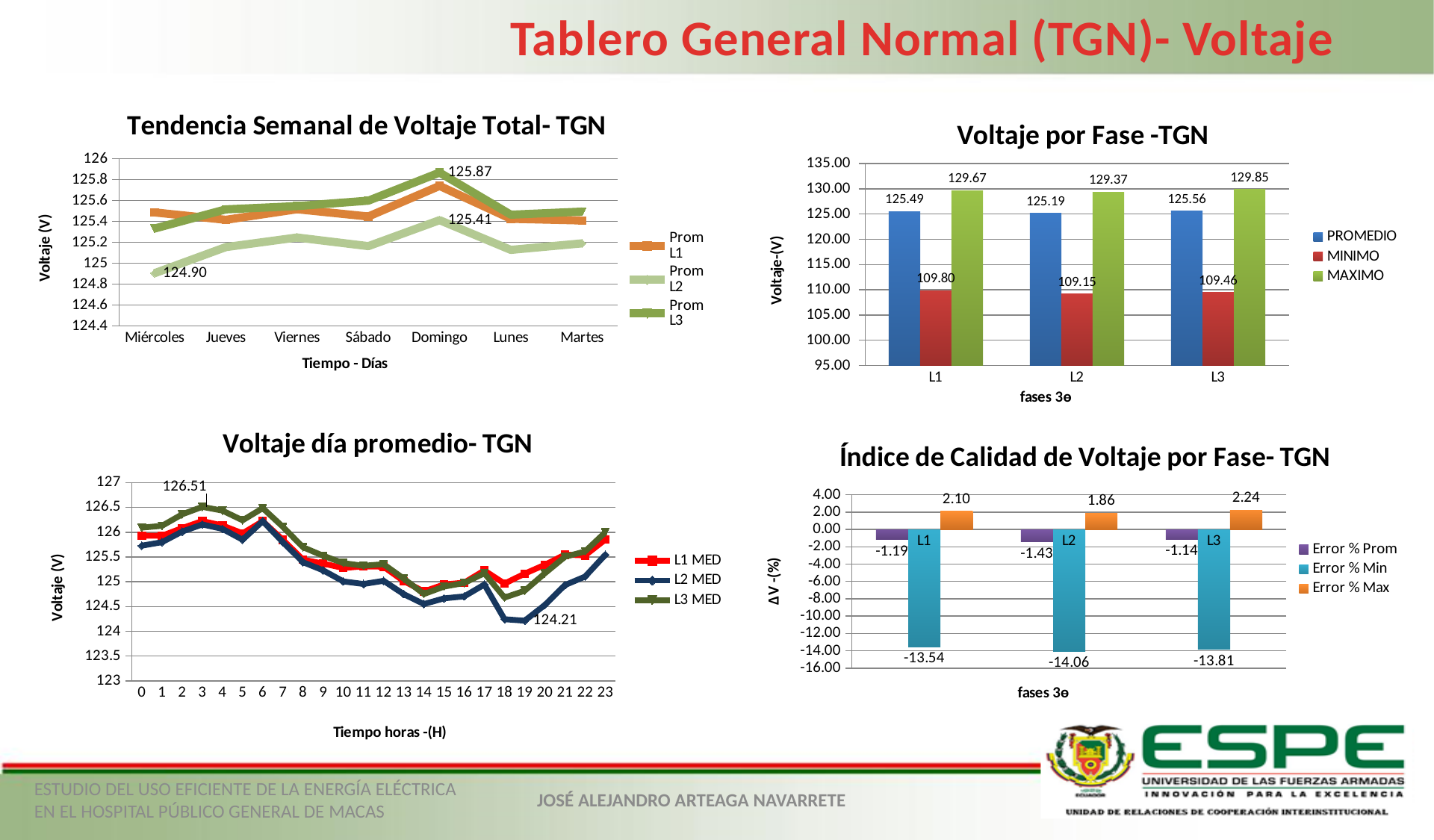
In the 'Índice de Calidad de Voltaje por Fase- TGN' chart, what is the Error % Min value for L2? -14.06 In the 'Voltaje día promedio- TGN' chart, what is the lowest labelled value shown? 124.21 In the 'Voltaje por Fase -TGN' chart, is the PROMEDIO value for L2 greater or less than 120.00? greater In the 'Tendencia Semanal de Voltaje Total- TGN' chart, how many days are shown on the x axis? 7 In the 'Voltaje por Fase -TGN' chart, what is the MAXIMO value for L3? 129.85 What kind of chart is 'Voltaje día promedio- TGN'? Line chart In the 'Tendencia Semanal de Voltaje Total- TGN' chart, what is the labelled value of Prom L3 on Domingo? 125.87 In the 'Voltaje por Fase -TGN' chart, what is the MINIMO value for L2? 109.15 In the 'Índice de Calidad de Voltaje por Fase- TGN' chart, how many series does the legend list? 3 In the 'Índice de Calidad de Voltaje por Fase- TGN' chart, which phase has the highest Error % Max value? L3 In the 'Voltaje por Fase -TGN' chart, what is the difference between the MAXIMO and MINIMO values for L1? 19.87 In the 'Voltaje por Fase -TGN' chart, which phase has the highest PROMEDIO value? L3